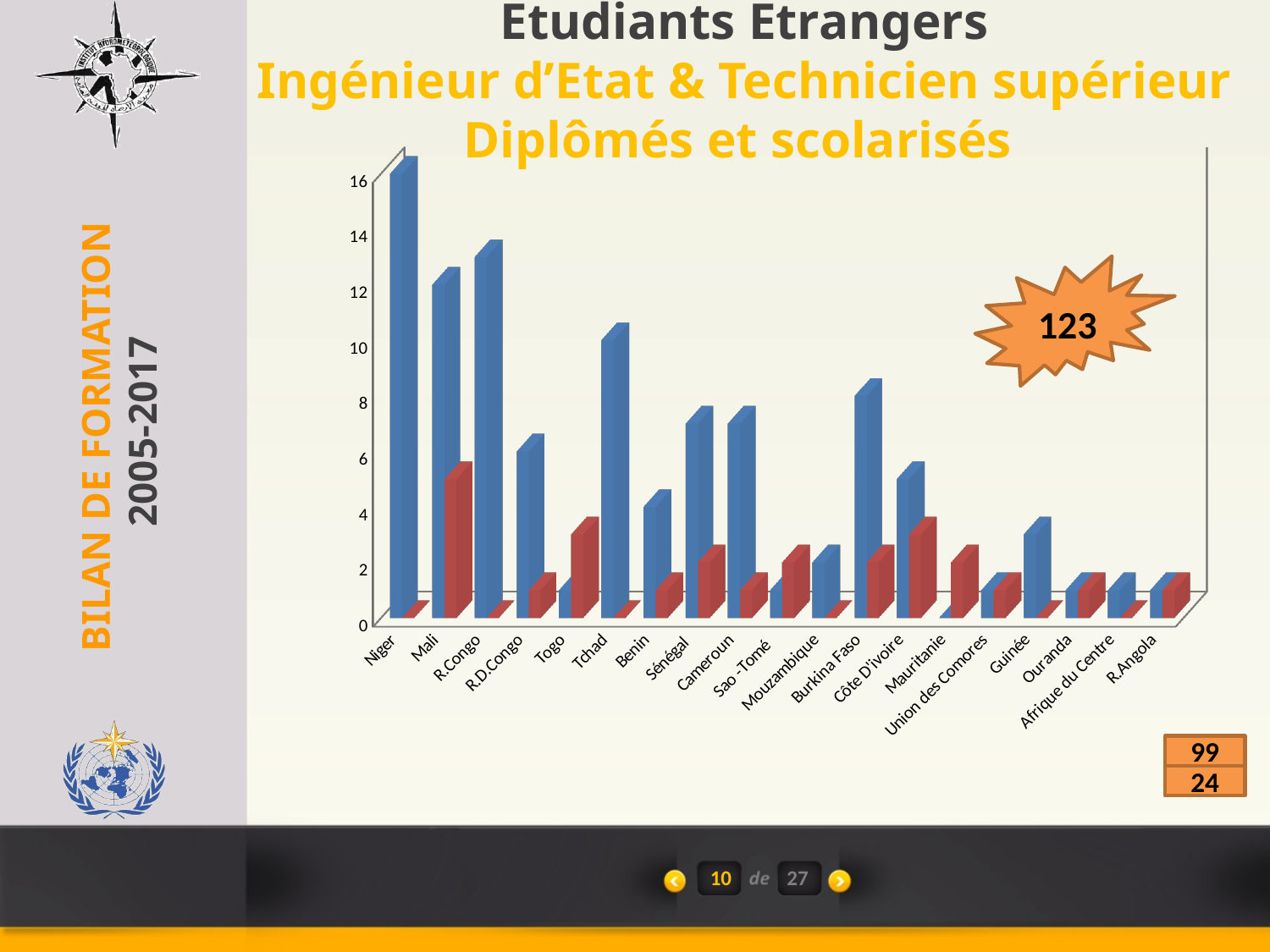
Is the blue bar for Tchad greater or less than 8? greater Is the blue bar for Niger greater or less than 14? greater Is the blue bar for Burkina Faso greater or less than 6? greater Which has the taller blue bar, Tchad or Benin? Tchad Which country has the tallest blue bar in the chart? Niger Which has the taller blue bar, R.Congo or R.D.Congo? R.Congo Which country has the tallest red bar in the chart? Mali What number is shown in the orange starburst on the chart? 123 What kind of chart is shown on the slide? bar chart How many countries are listed along the x axis of the chart? 19